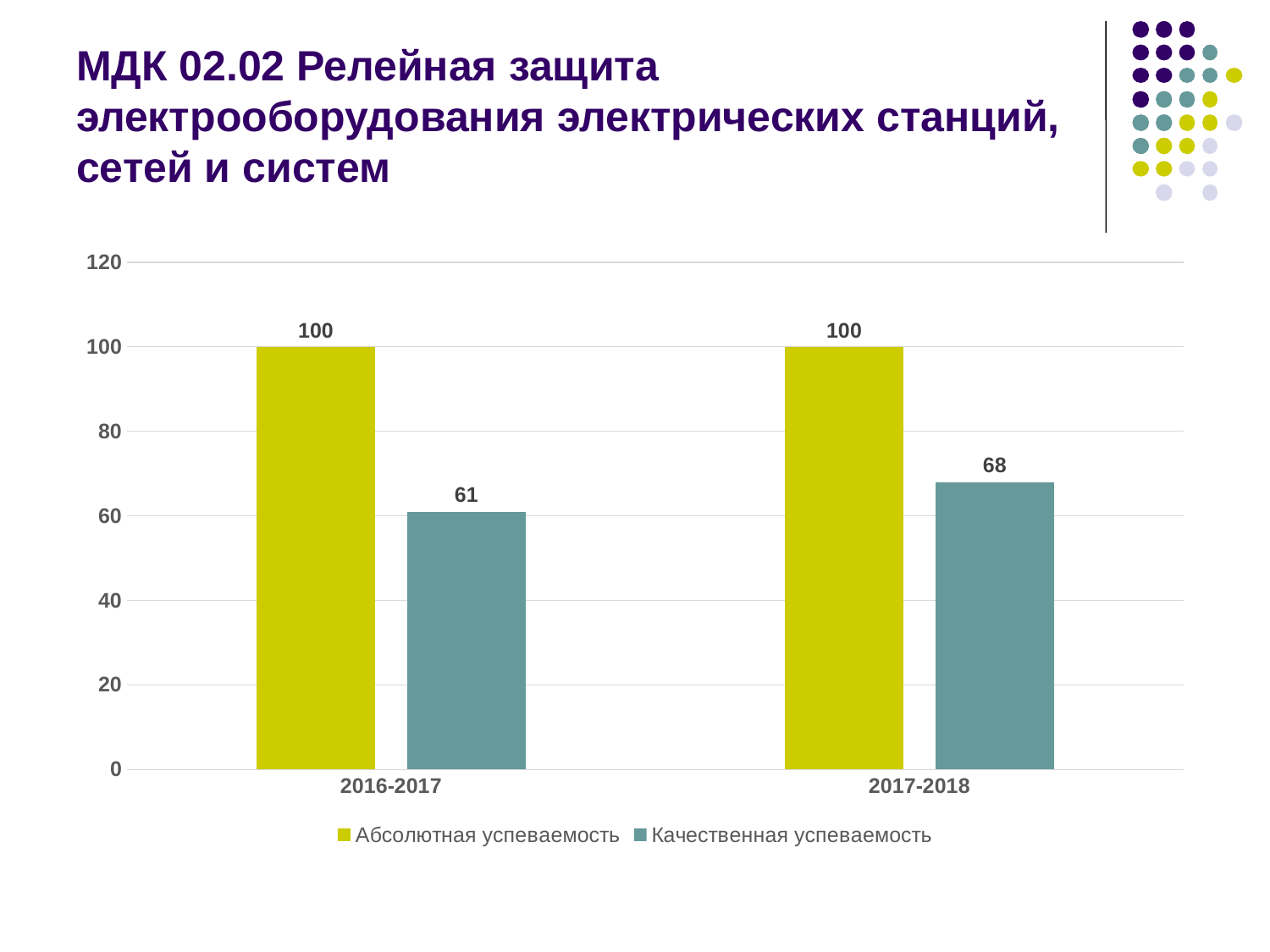
How many periods are shown on the x axis? 2 What is the difference between Качественная успеваемость in 2017-2018 and in 2016-2017? 7 What is the value of Качественная успеваемость for 2017-2018? 68 In which period is Качественная успеваемость highest? 2017-2018 What kind of chart is shown on the slide? Bar chart Which is larger in 2017-2018: Абсолютная успеваемость or Качественная успеваемость? Абсолютная успеваемость What is the value of Абсолютная успеваемость for 2017-2018? 100 What is the value of Качественная успеваемость for 2016-2017? 61 In which period is Качественная успеваемость lowest? 2016-2017 How many series does the legend list? 2 What is the value of Абсолютная успеваемость for 2016-2017? 100 What is the difference between Абсолютная успеваемость and Качественная успеваемость in 2016-2017? 39